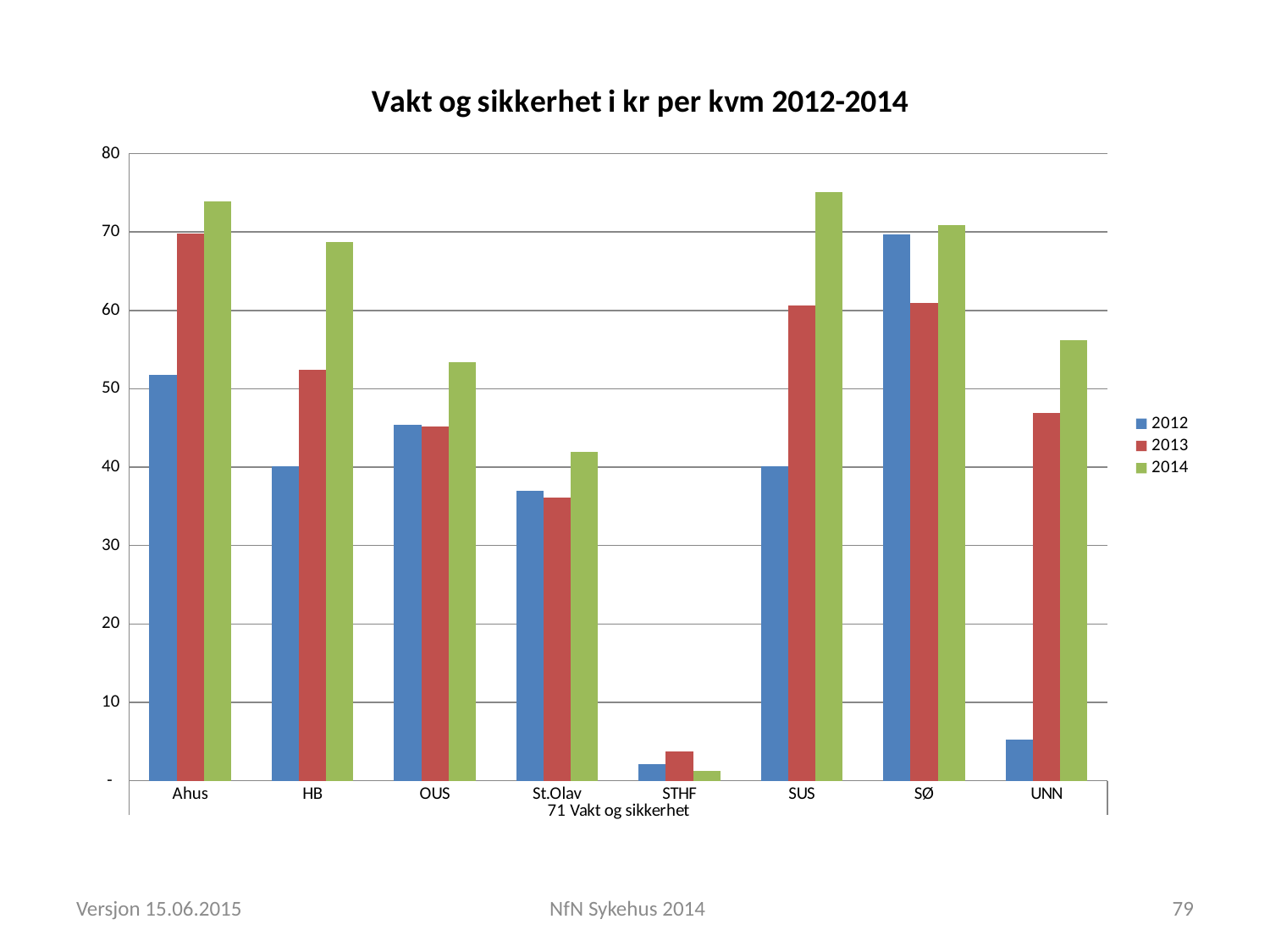
What kind of chart is shown on the slide? bar chart How many categories are shown on the x axis? 8 Is the value for UNN in 2013 greater or less than 40? greater Which category has the lowest value for 2014? STHF Is the value for Ahus in 2014 greater or less than 70? greater Which category has the highest value for 2013? Ahus How many series does the legend list? 3 For UNN, which year has the larger value: 2012 or 2014? 2014 What is the title of the chart? Vakt og sikkerhet i kr per kvm 2012-2014 Which is larger for 2013: Ahus or HB? Ahus Is the value for STHF in 2013 greater or less than 10? less Which category has the highest value for 2012? SØ